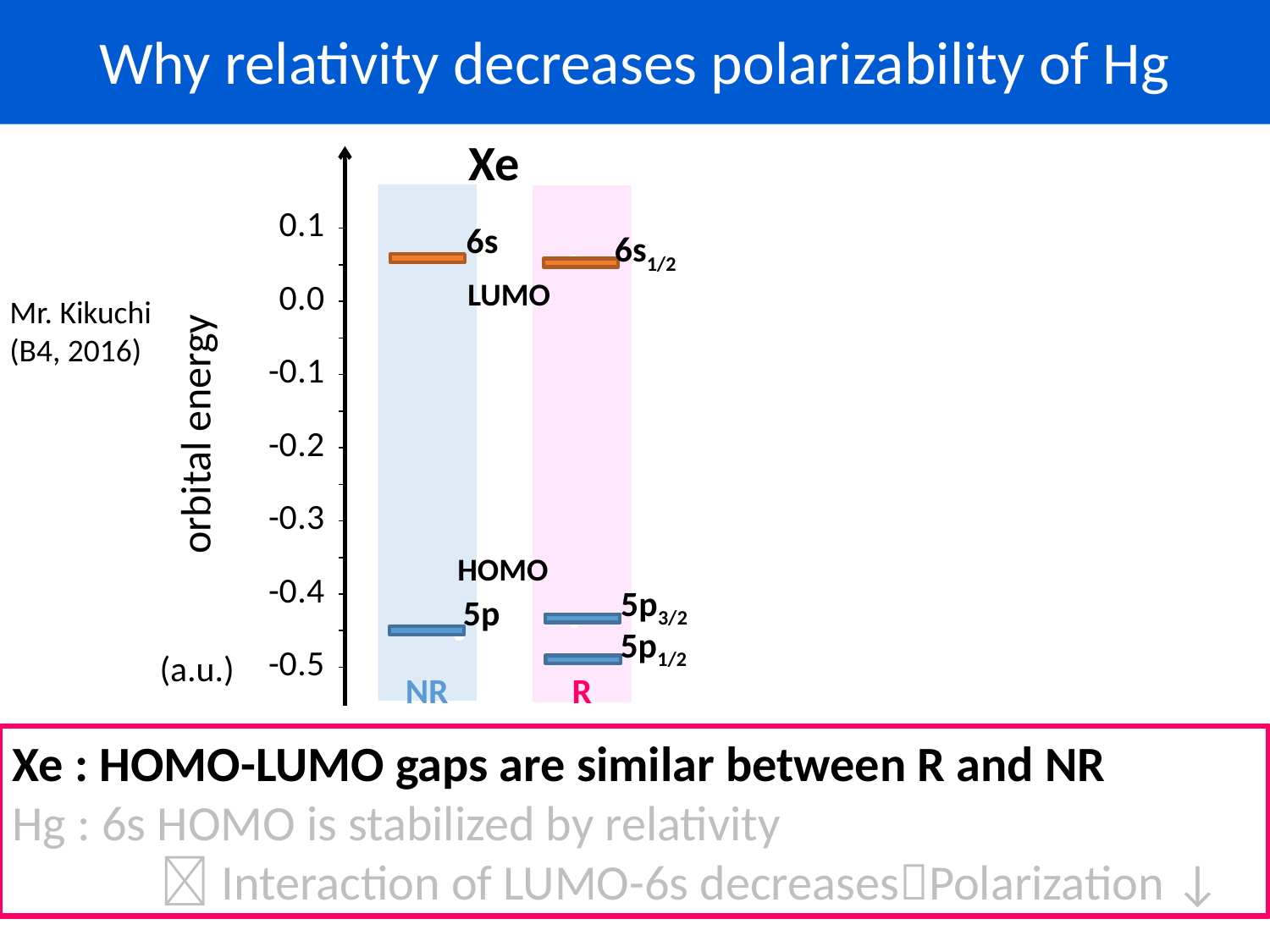
Which level is labelled as the LUMO on the chart? 6s Is the orbital energy of the 5p1/2 level in the R column greater or less than -0.4? less What unit is shown for the orbital energy axis? a.u. Is the orbital energy of the 5p level in the NR column greater or less than -0.4? less What is the title printed above the chart? Xe Which level has the higher orbital energy in the R column, 5p3/2 or 5p1/2? 5p3/2 Is the orbital energy of the 6s level in the NR column greater or less than 0.0? greater How many orbital energy levels are drawn in the R column? 3 Which level has the lowest orbital energy on the chart? 5p1/2 How many orbital energy levels are drawn in the NR column? 2